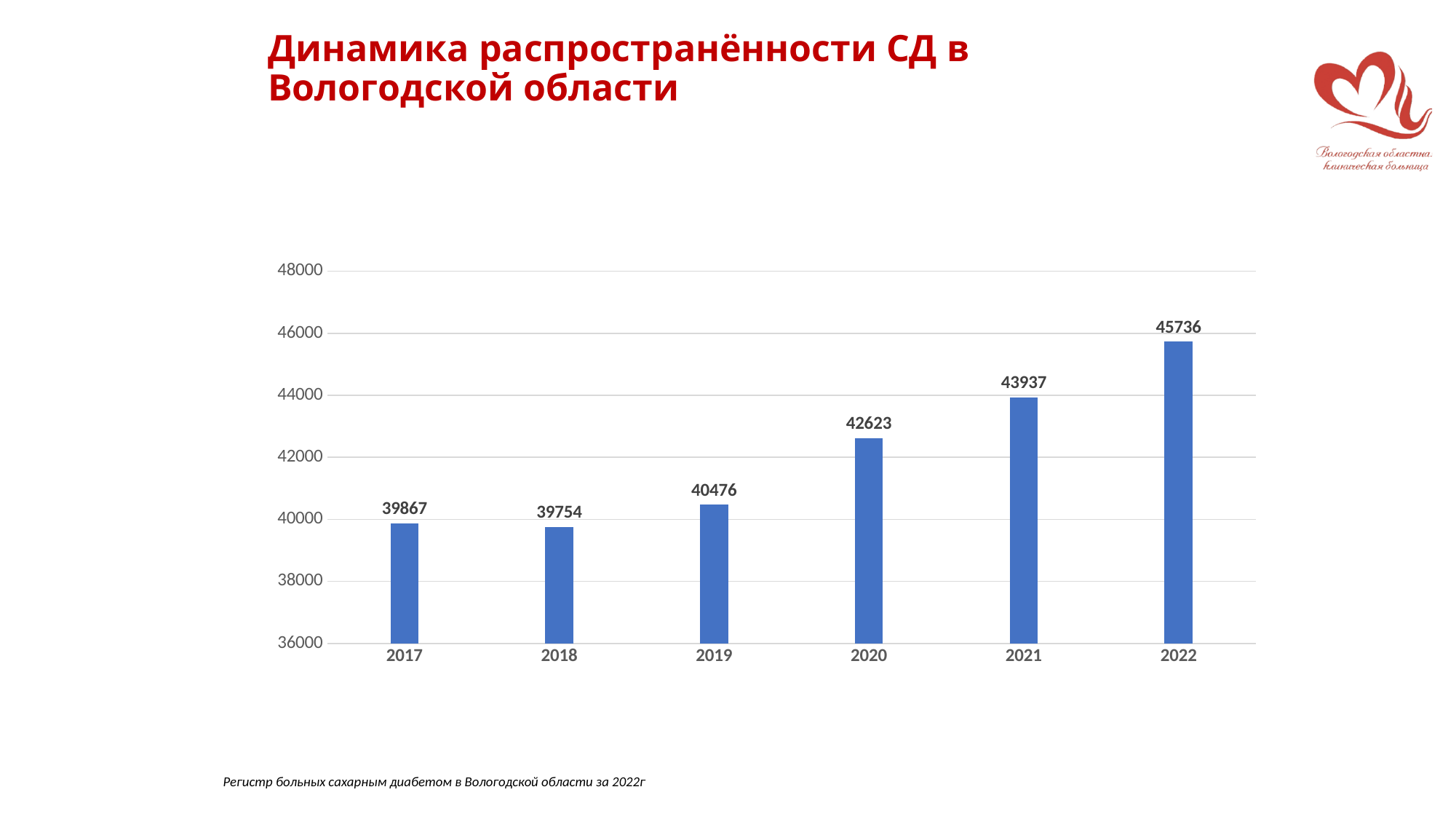
What kind of chart is shown on the slide? bar chart What is the difference between the values for 2022 and 2021? 1799 Is the value for 2021 greater or less than 44000? less What is the difference between the values for 2019 and 2018? 722 What is the value for 2020? 42623 Which is larger, the value for 2019 or the value for 2020? 2020 What is the value for 2022? 45736 Which year has the highest value? 2022 What is the value for 2017? 39867 Do the values generally rise or fall from 2018 to 2022? rise Which year has the lowest value? 2018 How many years are shown on the x axis? 6